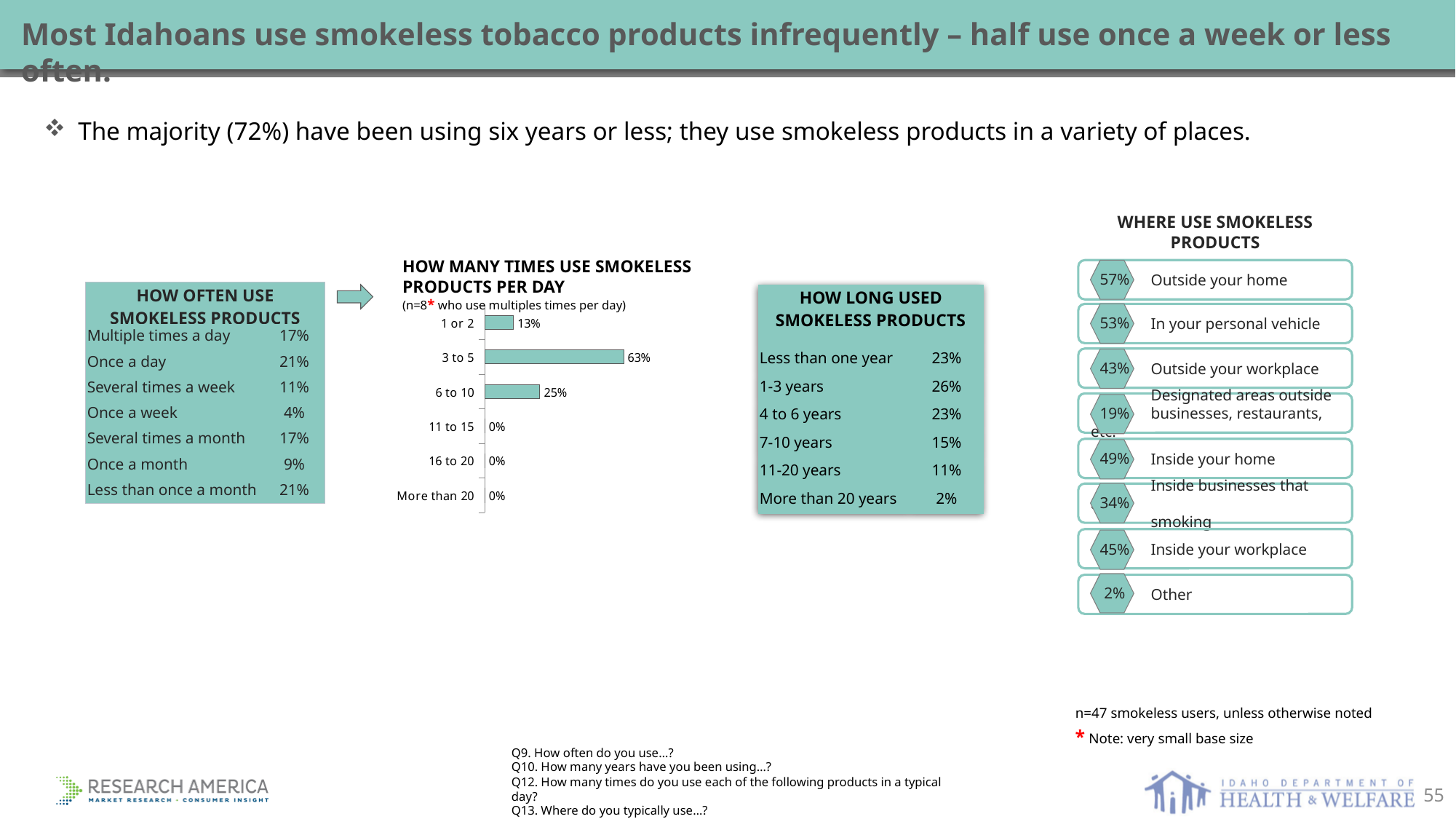
In the 'How many times use smokeless products per day' chart, what percentage is shown for '1 or 2'? 13% In the 'How many times use smokeless products per day' chart, what percentage is shown for '11 to 15'? 0% In the 'How many times use smokeless products per day' chart, which category has the highest value? 3 to 5 How many categories are shown in the 'How many times use smokeless products per day' chart? 6 In the 'How many times use smokeless products per day' chart, what is the difference between the values for '6 to 10' and '1 or 2'? 12% In the 'How many times use smokeless products per day' chart, what is the difference between the values for '3 to 5' and '6 to 10'? 38% In the 'How many times use smokeless products per day' chart, how many categories have a value of 0%? 3 What is the sample size noted under the title of the 'How many times use smokeless products per day' chart? n=8 What type of chart is 'How many times use smokeless products per day'? Bar chart In the 'How many times use smokeless products per day' chart, what percentage is shown for '3 to 5'? 63% In the 'How many times use smokeless products per day' chart, which is larger: the value for '1 or 2' or the value for '6 to 10'? 6 to 10 In the 'How many times use smokeless products per day' chart, what percentage is shown for '6 to 10'? 25%